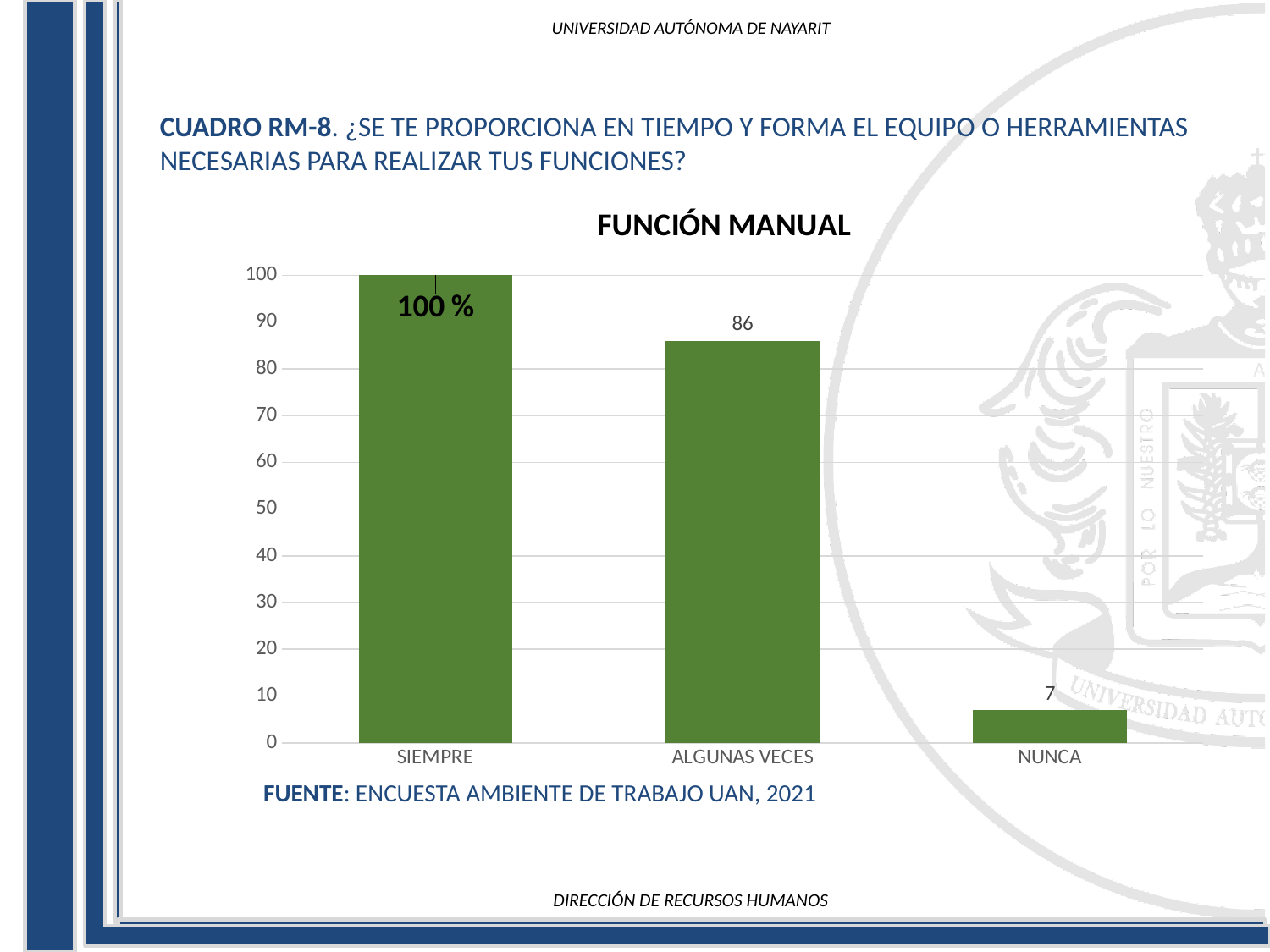
What is the difference between the values for ALGUNAS VECES and NUNCA in the FUNCIÓN MANUAL chart? 79 Do the values in the FUNCIÓN MANUAL chart rise or fall from left to right along the x axis? fall What is the value for ALGUNAS VECES in the FUNCIÓN MANUAL chart? 86 What value is labelled on the SIEMPRE bar in the FUNCIÓN MANUAL chart? 100 % Is the value for ALGUNAS VECES in the FUNCIÓN MANUAL chart greater or less than 80? greater Is the value for NUNCA in the FUNCIÓN MANUAL chart greater or less than 10? less What is the value for NUNCA in the FUNCIÓN MANUAL chart? 7 Which category has the lowest value in the FUNCIÓN MANUAL chart? NUNCA Which is larger in the FUNCIÓN MANUAL chart, ALGUNAS VECES or NUNCA? ALGUNAS VECES How many categories are shown on the x axis of the FUNCIÓN MANUAL chart? 3 Which category has the highest value in the FUNCIÓN MANUAL chart? SIEMPRE What kind of chart is the FUNCIÓN MANUAL chart? bar chart